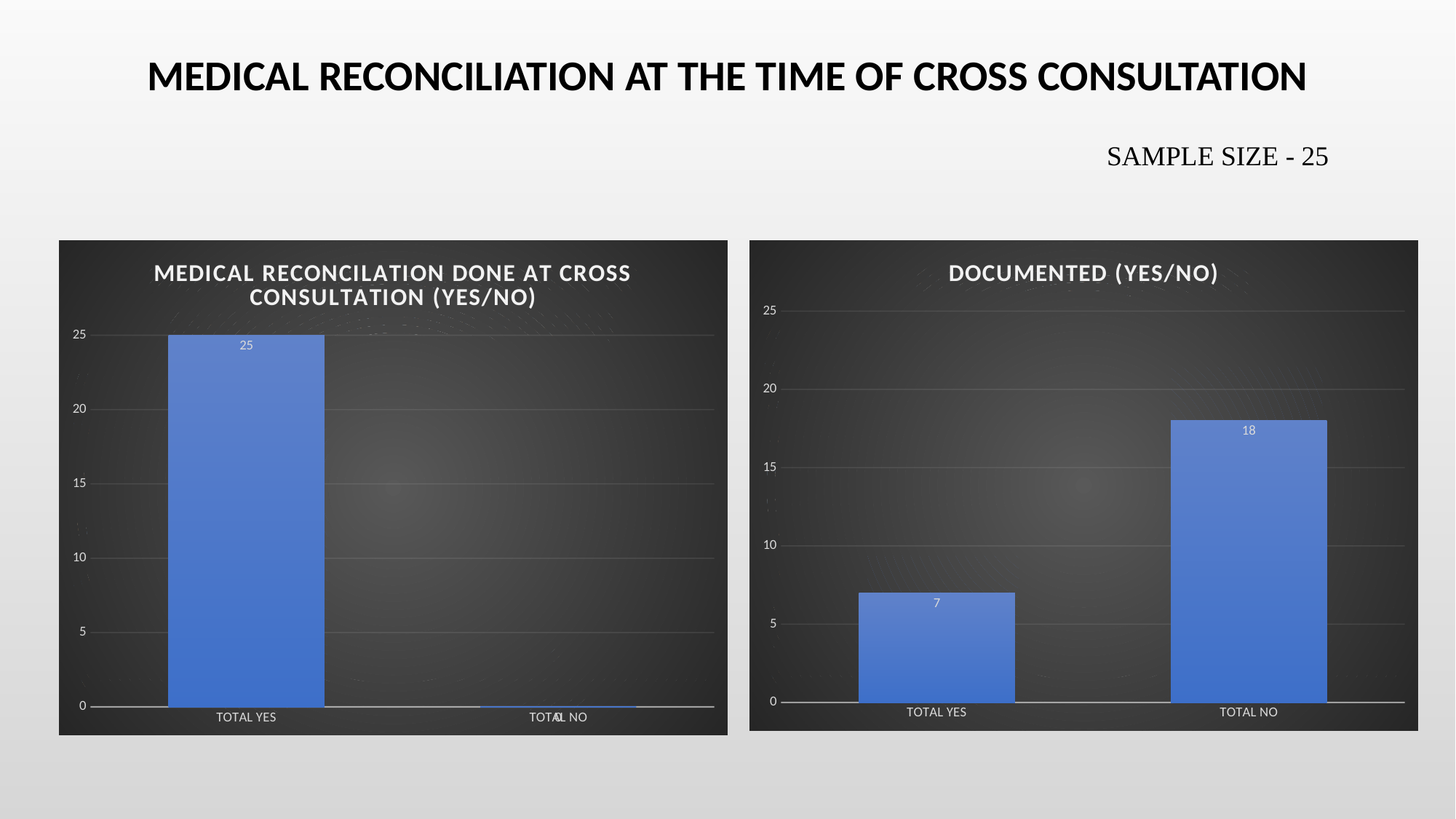
In the right chart titled 'Documented (Yes/No)', what is the value for TOTAL NO? 18 What is the title of the right chart on the slide? DOCUMENTED (YES/NO) In the left chart titled 'Medical Reconcilation Done at Cross Consultation (Yes/No)', which is larger, TOTAL YES or TOTAL NO? TOTAL YES In the left chart titled 'Medical Reconcilation Done at Cross Consultation (Yes/No)', what is the value for TOTAL YES? 25 How many categories are shown in the right chart titled 'Documented (Yes/No)'? 2 In the right chart titled 'Documented (Yes/No)', is the value for TOTAL NO greater or less than 15? greater In the right chart titled 'Documented (Yes/No)', which category has the lowest value? TOTAL YES In the right chart titled 'Documented (Yes/No)', what is the value for TOTAL YES? 7 What kind of chart is the left chart titled 'Medical Reconcilation Done at Cross Consultation (Yes/No)'? Bar chart In the right chart titled 'Documented (Yes/No)', what is the difference between TOTAL NO and TOTAL YES? 11 In the right chart titled 'Documented (Yes/No)', which category has the highest value? TOTAL NO In the left chart titled 'Medical Reconcilation Done at Cross Consultation (Yes/No)', what is the value for TOTAL NO? 0